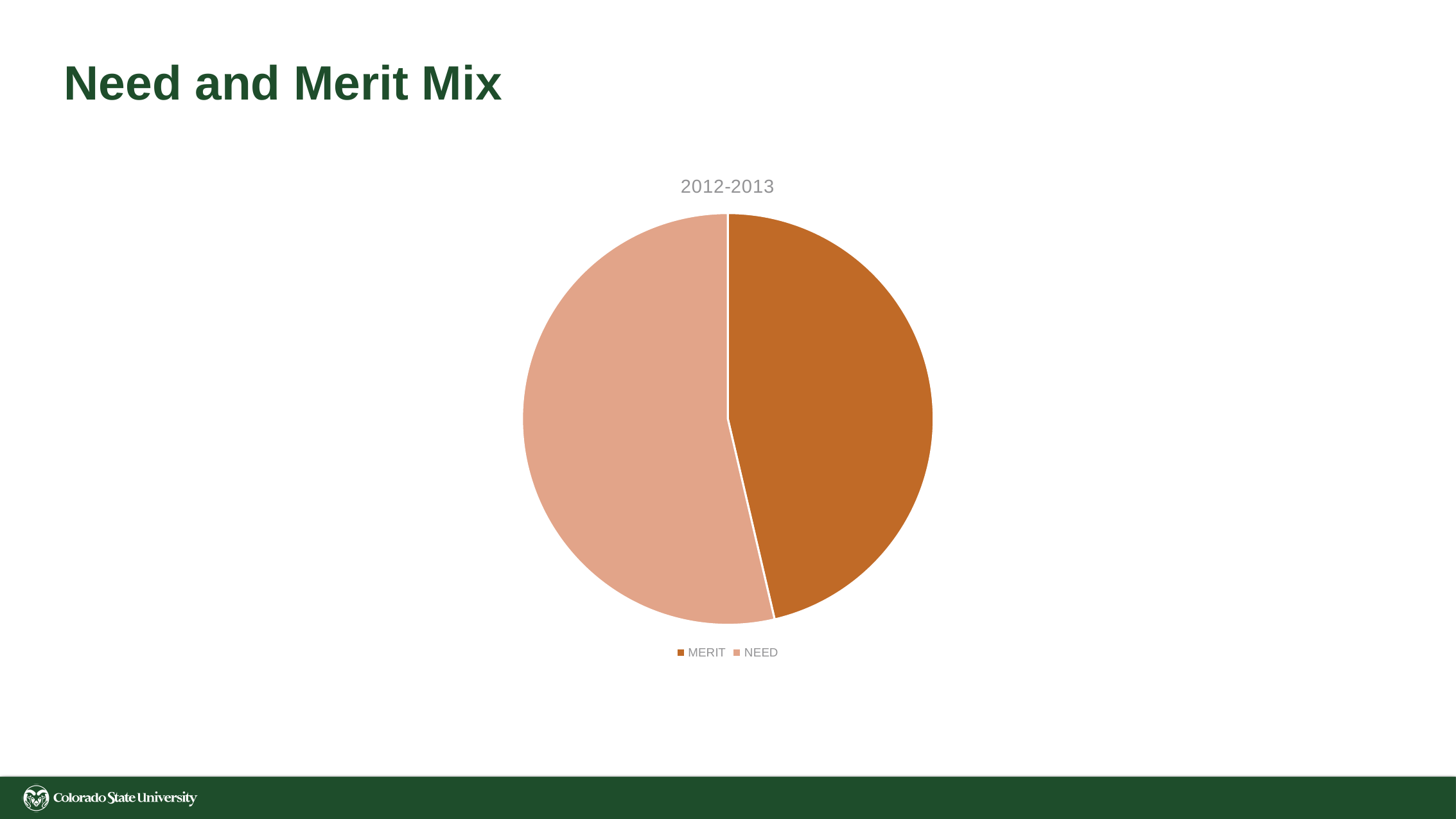
What kind of chart is shown on the slide? pie chart Which slice is larger, MERIT or NEED? NEED What is the title of the chart? 2012-2013 Which category has the largest slice of the pie? NEED How many entries does the legend list? 2 Which legend entry is shown in the darker orange colour? MERIT Which category has the smallest slice of the pie? MERIT How many slices does the pie chart have? 2